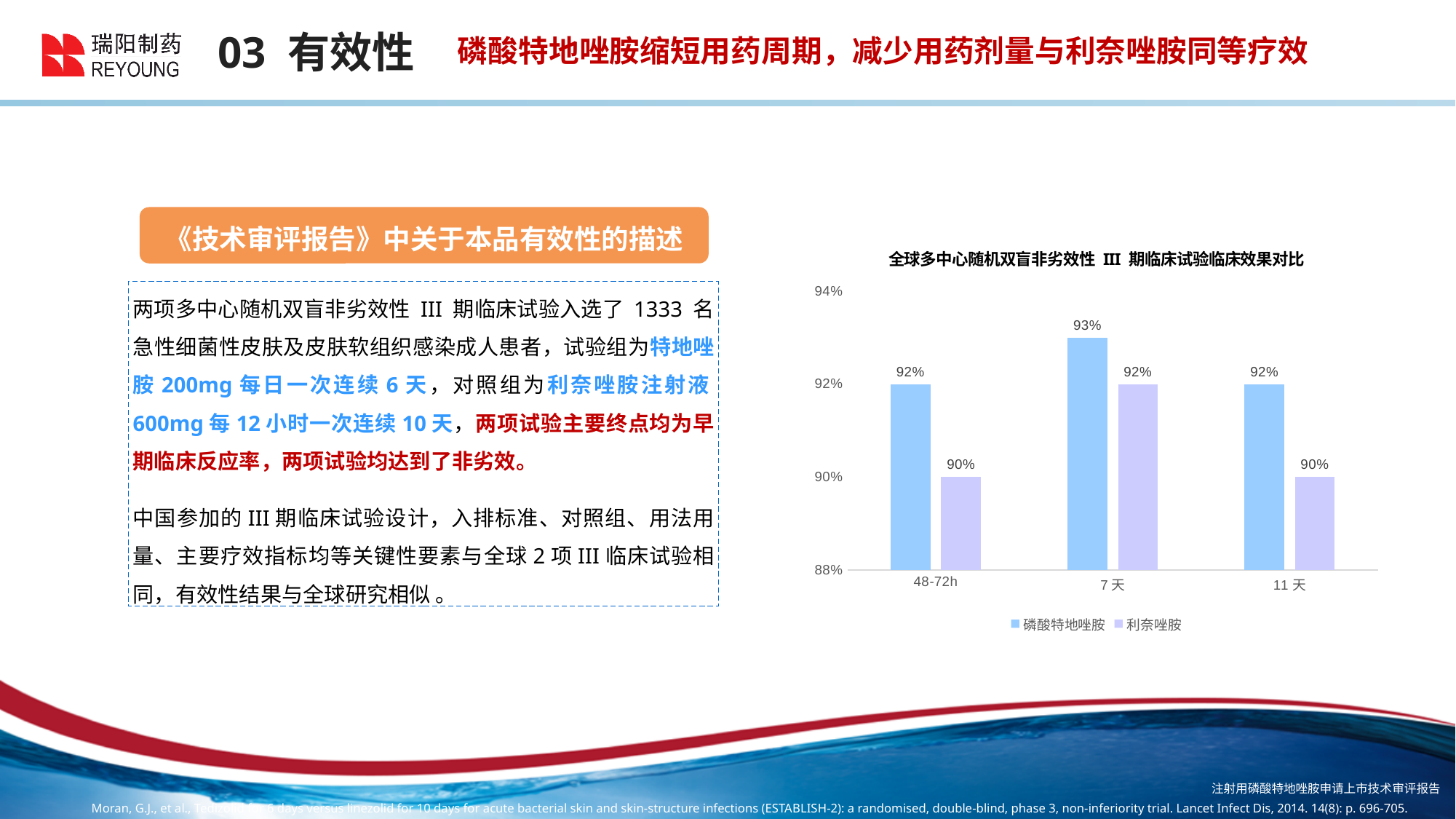
Which series has the larger value at 11 天, 磷酸特地唑胺 or 利奈唑胺? 磷酸特地唑胺 What is the value for 磷酸特地唑胺 at 48-72h? 92% How many time-point categories are shown on the x axis? 3 At which time point is the value for 磷酸特地唑胺 highest? 7 天 What kind of chart is shown on the slide? Bar chart What is the value for 利奈唑胺 at 7 天? 92% What is the difference between 磷酸特地唑胺 and 利奈唑胺 at 7 天? 1% Which series is shown in the lighter purple colour in the legend? 利奈唑胺 How many series does the legend list? 2 What is the title of the chart? 全球多中心随机双盲非劣效性 III 期临床试验临床效果对比 What is the value for 利奈唑胺 at 11 天? 90% What is the difference between 磷酸特地唑胺 and 利奈唑胺 at 48-72h? 2%